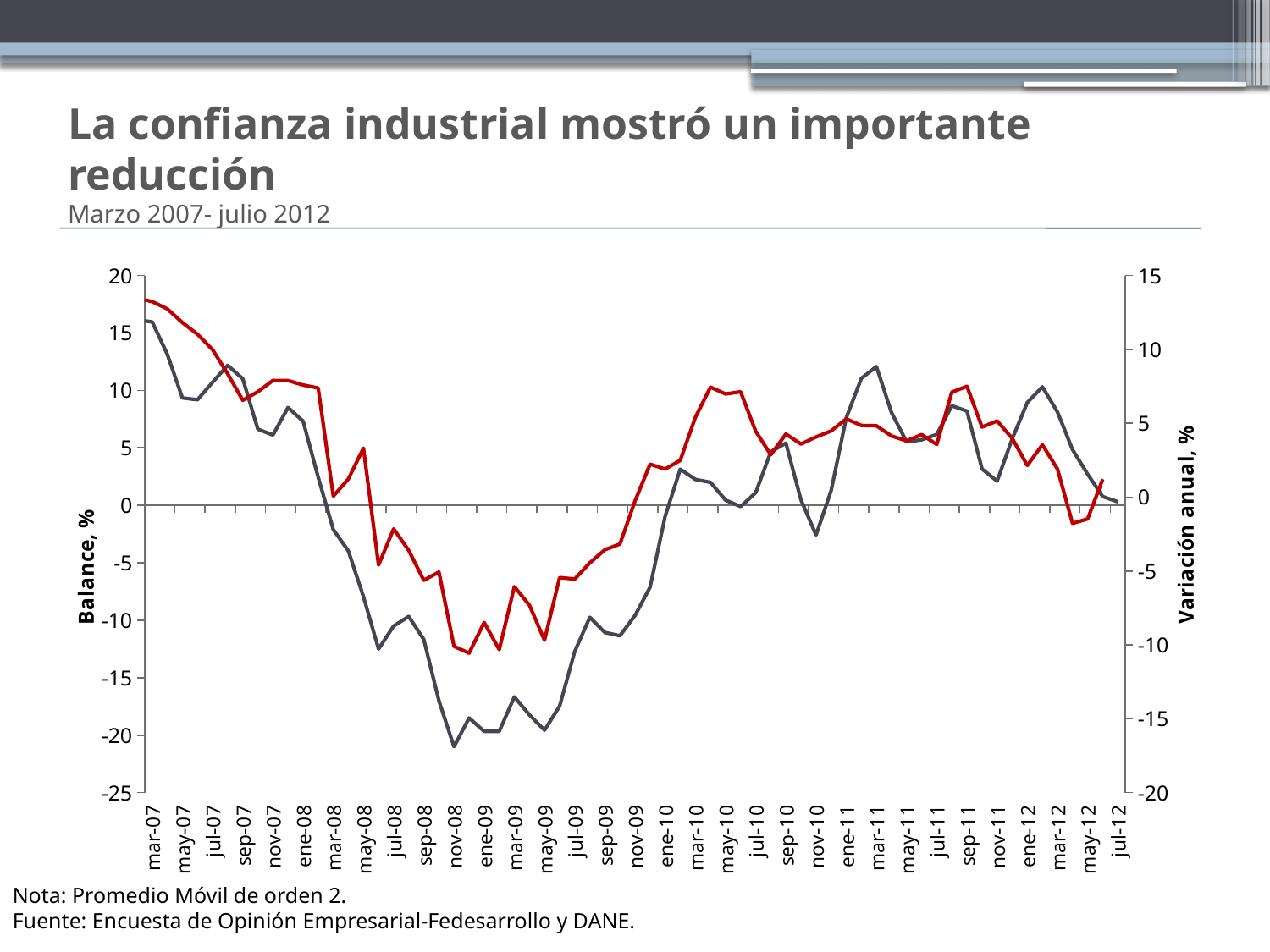
Is the value of the red line at may-10 greater or less than 0? greater What is the label of the right vertical axis? Variación anual, % Is the value of the dark grey line at nov-08 greater or less than -10? less How many lines are plotted on the chart? 2 Is the value of the red line at nov-08 greater or less than 0? less Does the dark grey line rise or fall between nov-08 and mar-10? rise What kind of chart is shown on the slide? line chart Does the red line rise or fall between mar-07 and nov-08? fall What is the label of the left vertical axis? Balance, % What is the first month shown on the x axis? mar-07